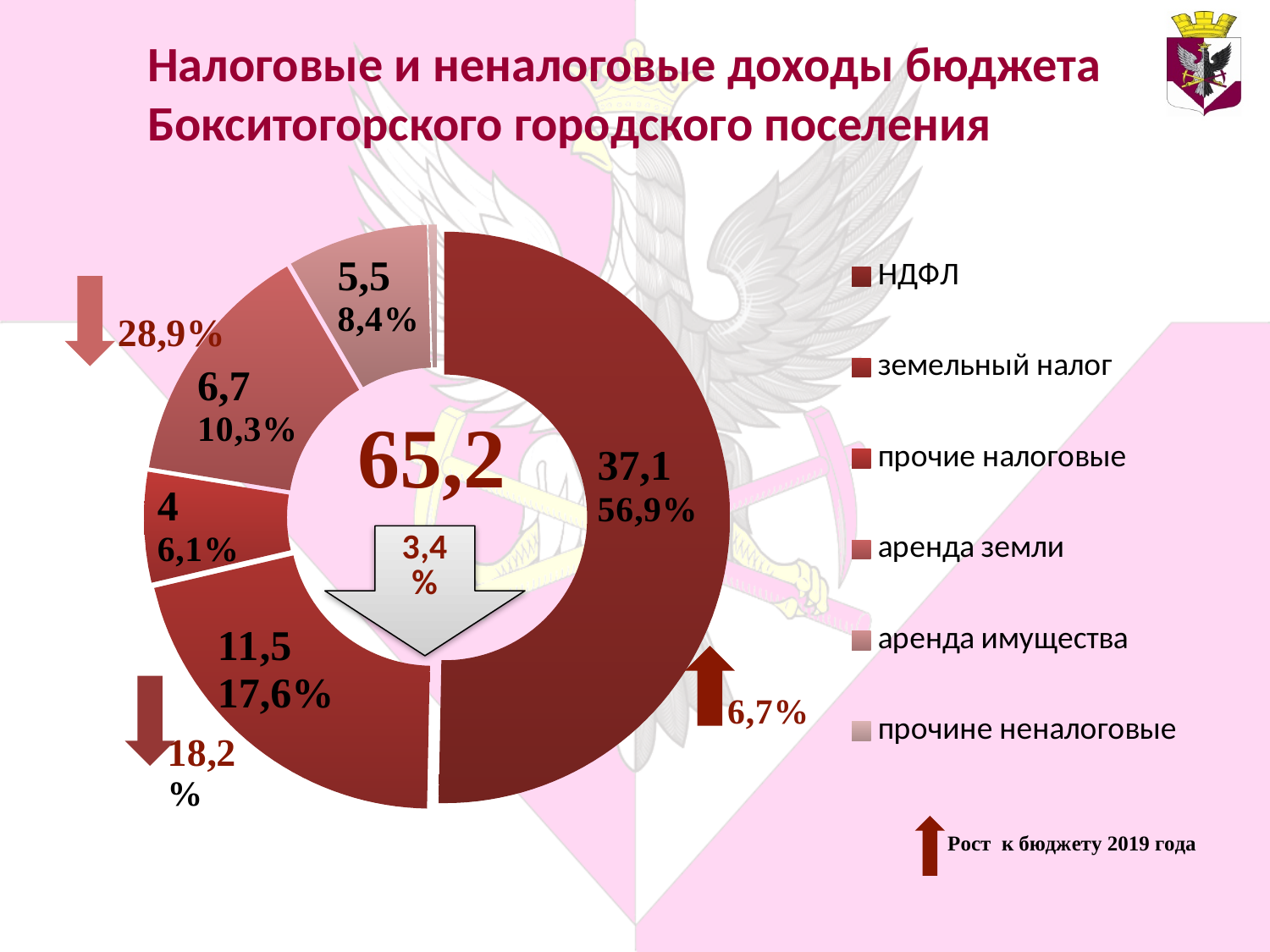
What total value is shown in the centre of the doughnut chart? 65,2 What percentage share is shown for аренда земли? 10,3% Which category has the largest slice in the chart? НДФЛ What type of chart is shown on the slide? Doughnut (pie) chart What is the difference between the value for НДФЛ and the value for земельный налог? 25,6 What is the value shown for земельный налог? 11,5 Which is larger, the value for аренда земли or the value for аренда имущества? аренда земли What share of the total does НДФЛ account for? 56,9% What is the value shown for НДФЛ? 37,1 What percentage share is shown for прочие налоговые? 6,1% How many categories does the legend of the chart list? 6 What is the value shown for аренда имущества? 5,5